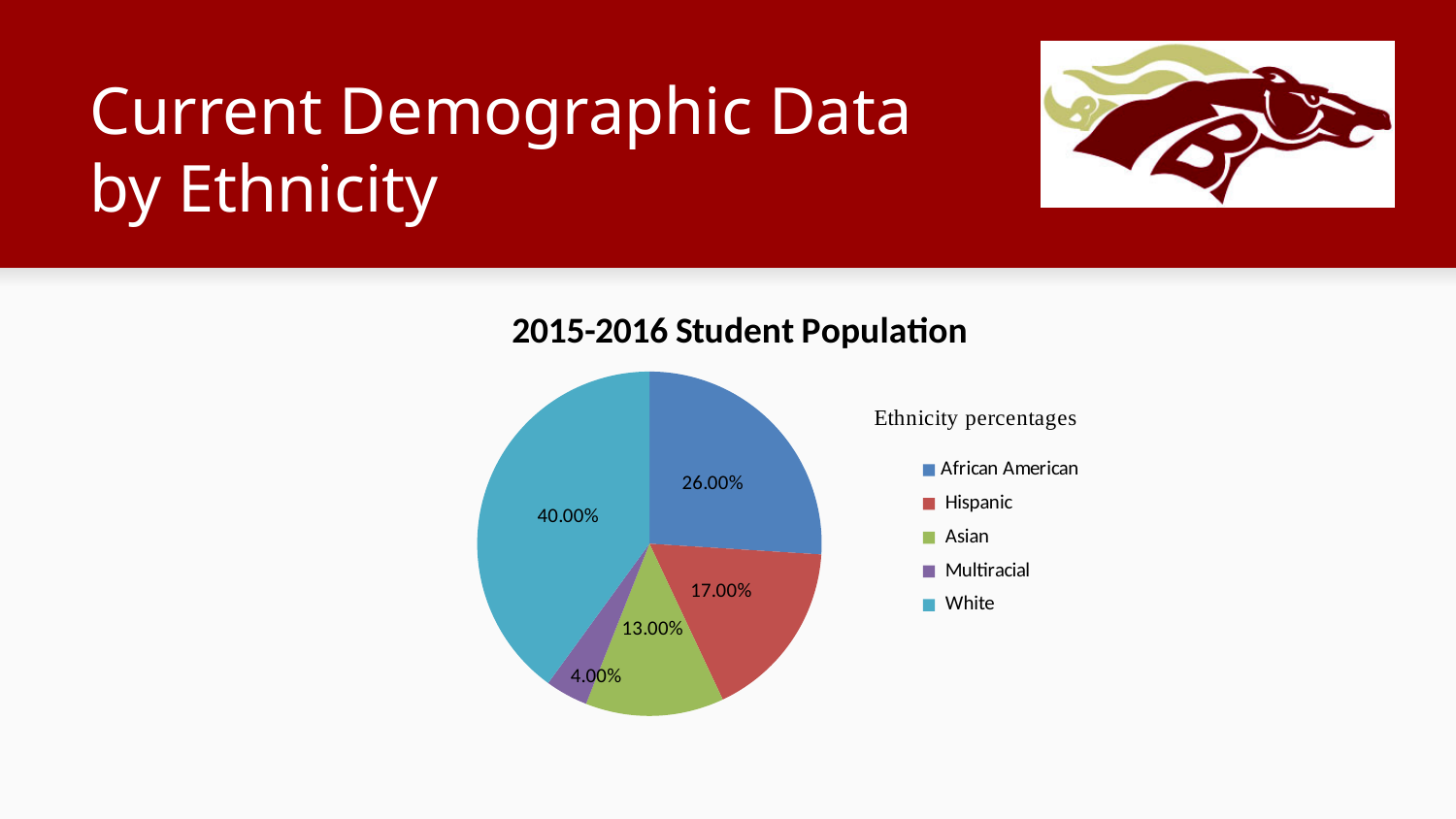
What percentage of the student population is White? 40.00% Which ethnicity has the smallest share of the student population? Multiracial What percentage of the student population is Hispanic? 17.00% Which is larger, the Hispanic share or the Asian share? Hispanic What is the chart's title? 2015-2016 Student Population What kind of chart is shown on the slide? pie chart What percentage of the student population is African American? 26.00% What percentage of the student population is Asian? 13.00% Which ethnicity has the largest share of the student population? White What is the difference between the White and African American percentages? 14.00% How many ethnicity categories does the legend list? 5 What percentage of the student population is Multiracial? 4.00%